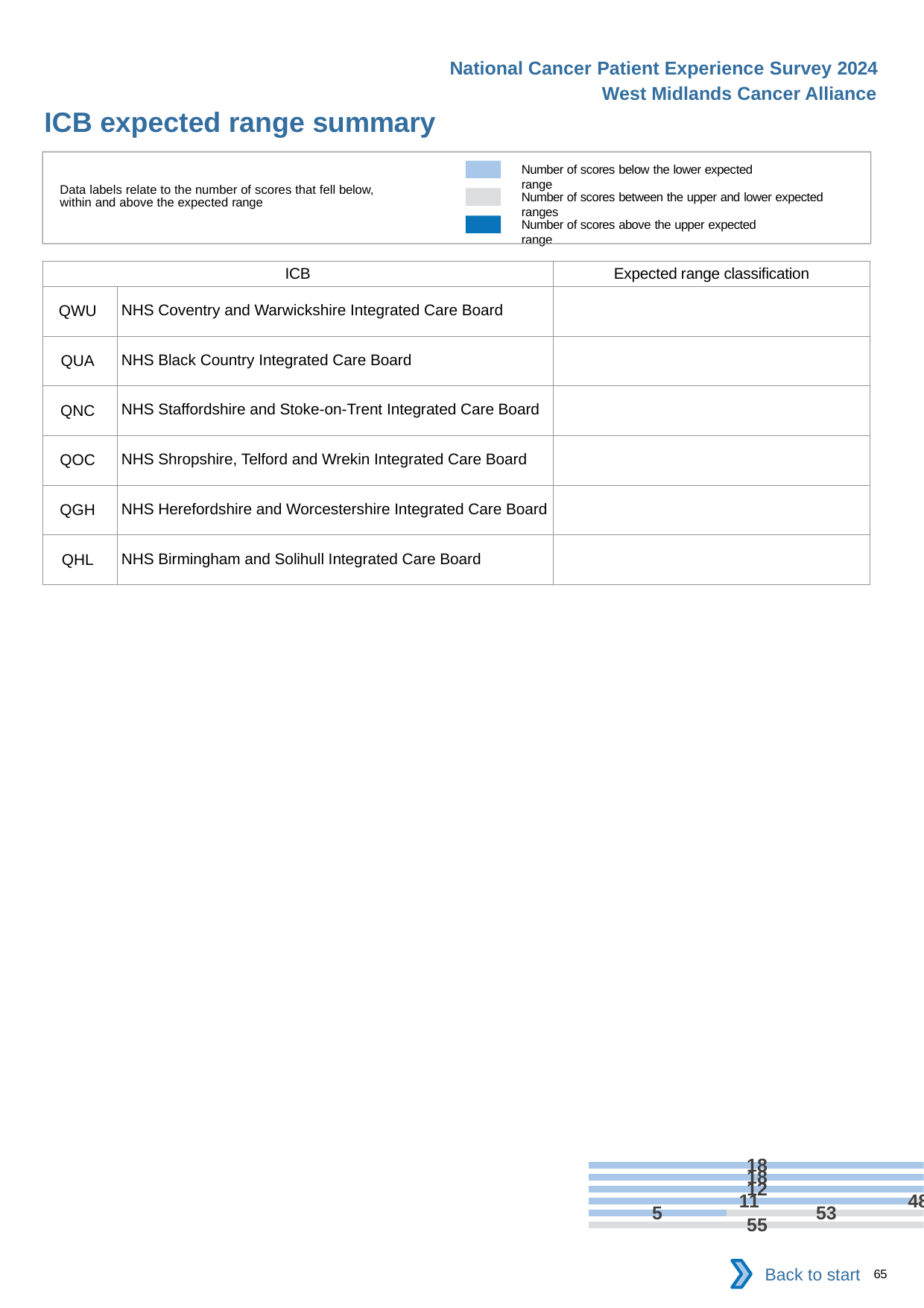
How many series does the colour key at the top of the slide list? 3 What is the largest data label printed on the chart at the bottom right? 55 What kind of chart is shown at the bottom right of the slide? bar chart According to the key, what does the dark blue colour represent? Number of scores above the upper expected range What is the smallest data label printed on the chart at the bottom right? 5 According to the key, what does the light blue colour represent? Number of scores below the lower expected range On the chart at the bottom right, is the data label 53 larger or smaller than the data label 48? larger